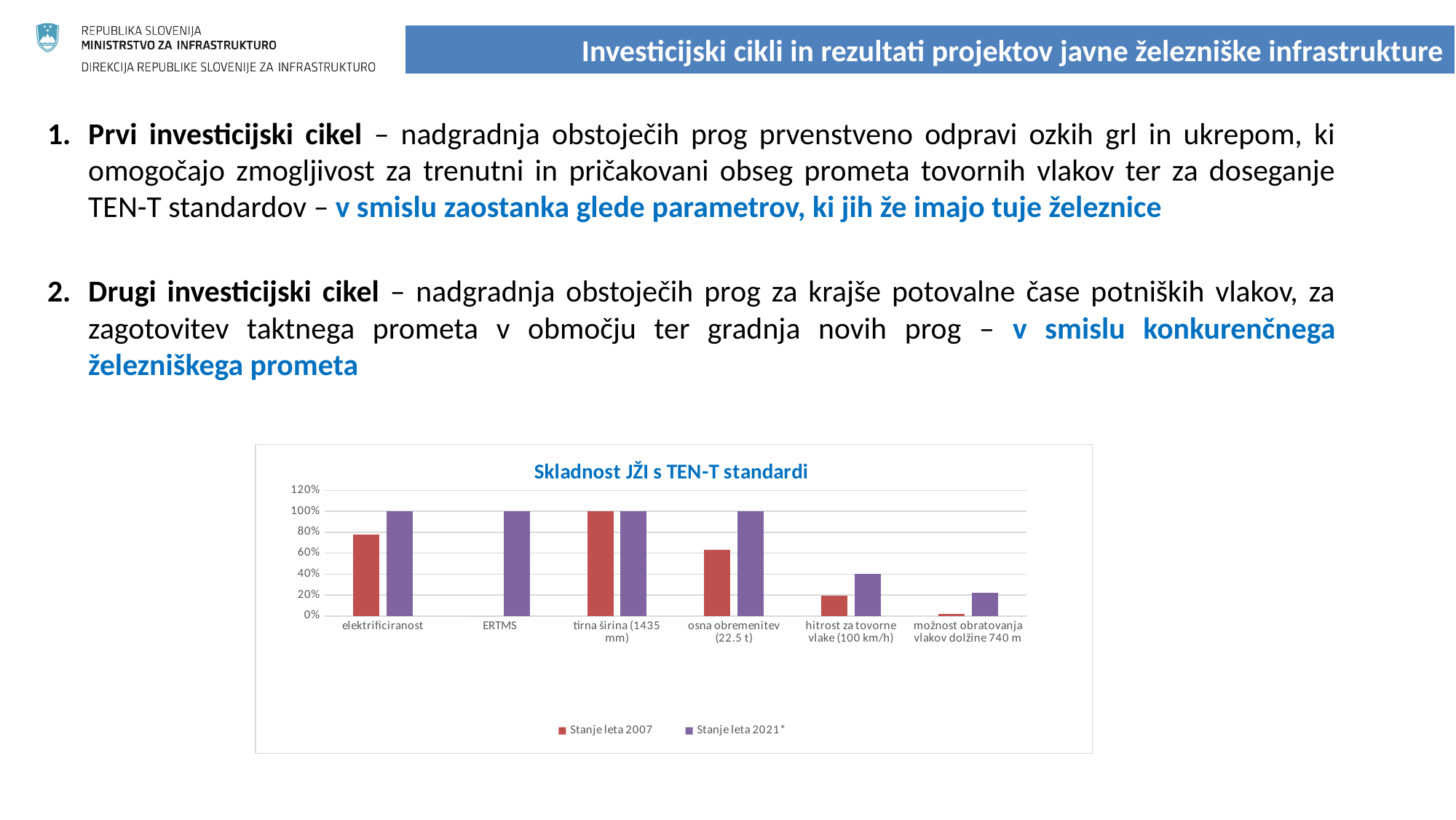
Which series is shown in purple in the chart? Stanje leta 2021* Is the value for Stanje leta 2007 for osna obremenitev (22.5 t) greater or less than 80%? less What is the value for Stanje leta 2021* for ERTMS? 100% For osna obremenitev (22.5 t), which series has the larger value, Stanje leta 2007 or Stanje leta 2021*? Stanje leta 2021* Which category has the lowest value for Stanje leta 2021*? možnost obratovanja vlakov dolžine 740 m What is the value for Stanje leta 2007 for tirna širina (1435 mm)? 100% What is the title of the chart? Skladnost JŽI s TEN-T standardi How many series does the chart legend list? 2 How many categories are shown on the x axis of the chart? 6 What kind of chart is shown on the slide? bar chart Is the value for Stanje leta 2007 for elektrificiranost greater or less than 60%? greater